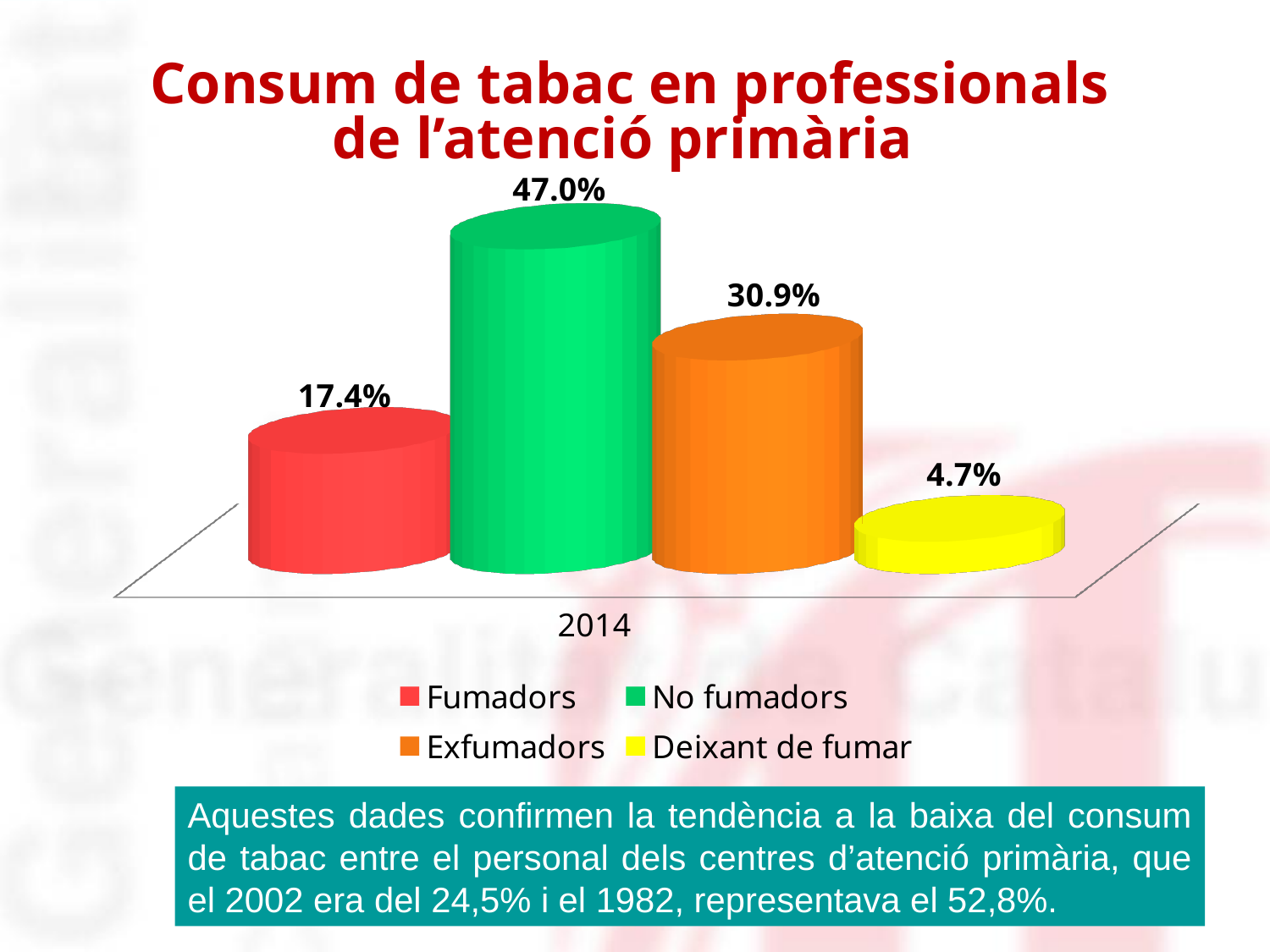
Which series has the lowest value? Deixant de fumar Which series has the highest value? No fumadors What is the difference between the values for No fumadors and Exfumadors? 16.1% What is the value for Fumadors? 17.4% What is the difference between the values for Fumadors and Deixant de fumar? 12.7% What is the value for Exfumadors? 30.9% Which is larger, the value for Fumadors or the value for Exfumadors? Exfumadors What kind of chart is shown? Bar chart What year is shown on the x axis? 2014 What is the value for Deixant de fumar? 4.7% What is the value for No fumadors? 47.0% How many series does the legend list? 4